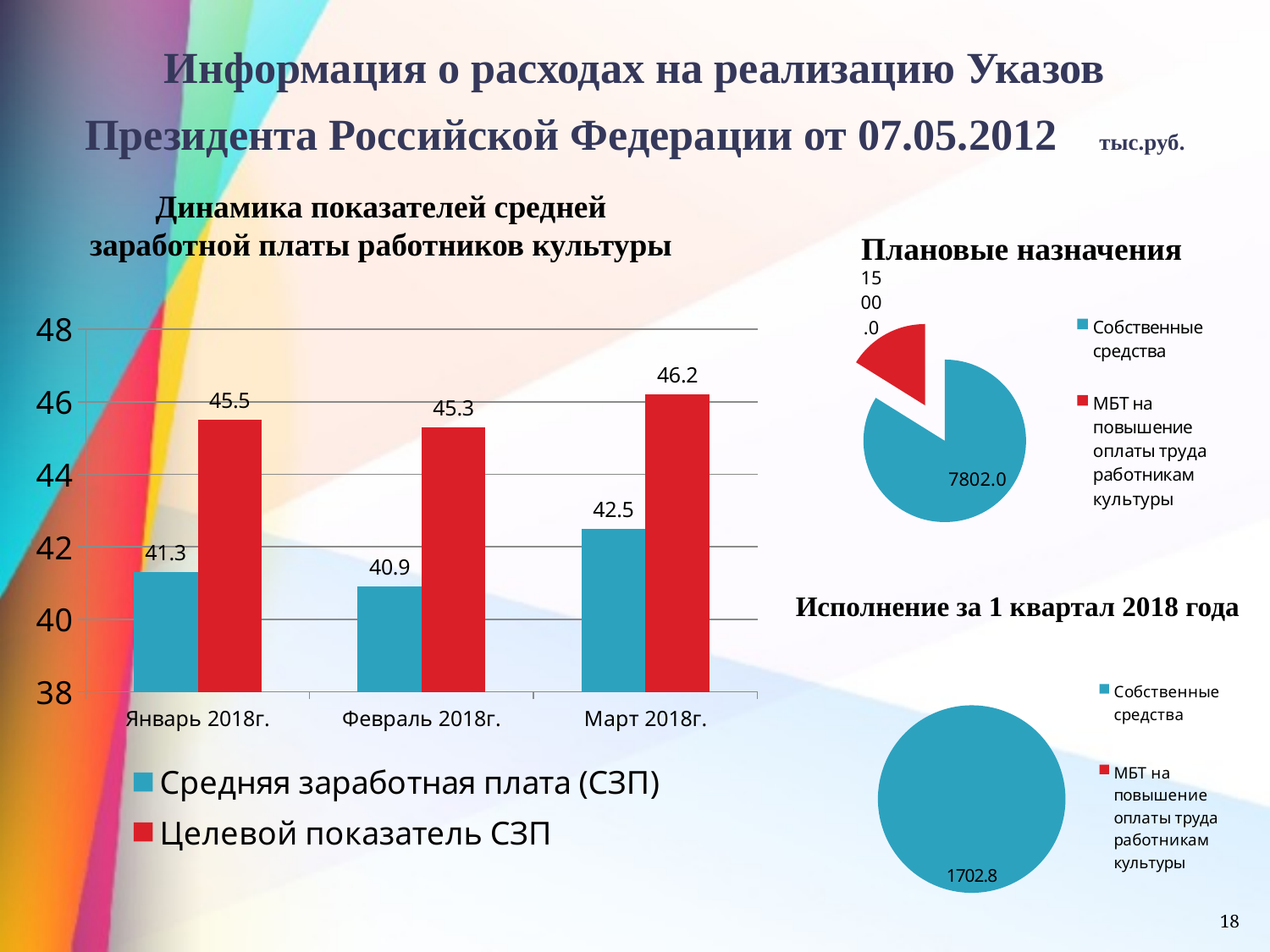
On the bar chart 'Динамика показателей средней заработной платы работников культуры', what is the difference between 'Целевой показатель СЗП' and 'Средняя заработная плата (СЗП)' for Март 2018г.? 3.7 On the bar chart 'Динамика показателей средней заработной платы работников культуры', in which month is 'Средняя заработная плата (СЗП)' lowest? Февраль 2018г. On the bar chart 'Динамика показателей средней заработной платы работников культуры', which is larger for Январь 2018г.: 'Средняя заработная плата (СЗП)' or 'Целевой показатель СЗП'? Целевой показатель СЗП What kind of chart is 'Плановые назначения'? Pie chart On the bar chart 'Динамика показателей средней заработной платы работников культуры', what is the value of 'Целевой показатель СЗП' for Март 2018г.? 46.2 On the bar chart 'Динамика показателей средней заработной платы работников культуры', what is the value of 'Средняя заработная плата (СЗП)' for Январь 2018г.? 41.3 On the pie chart 'Плановые назначения', what is the value of 'Собственные средства'? 7802.0 On the pie chart 'Исполнение за 1 квартал 2018 года', what is the value of 'Собственные средства'? 1702.8 On the bar chart 'Динамика показателей средней заработной платы работников культуры', how many months are shown on the x axis? 3 On the bar chart 'Динамика показателей средней заработной платы работников культуры', how many series does the legend list? 2 On the bar chart 'Динамика показателей средней заработной платы работников культуры', what is the value of 'Целевой показатель СЗП' for Февраль 2018г.? 45.3 On the bar chart 'Динамика показателей средней заработной платы работников культуры', in which month is 'Целевой показатель СЗП' highest? Март 2018г.